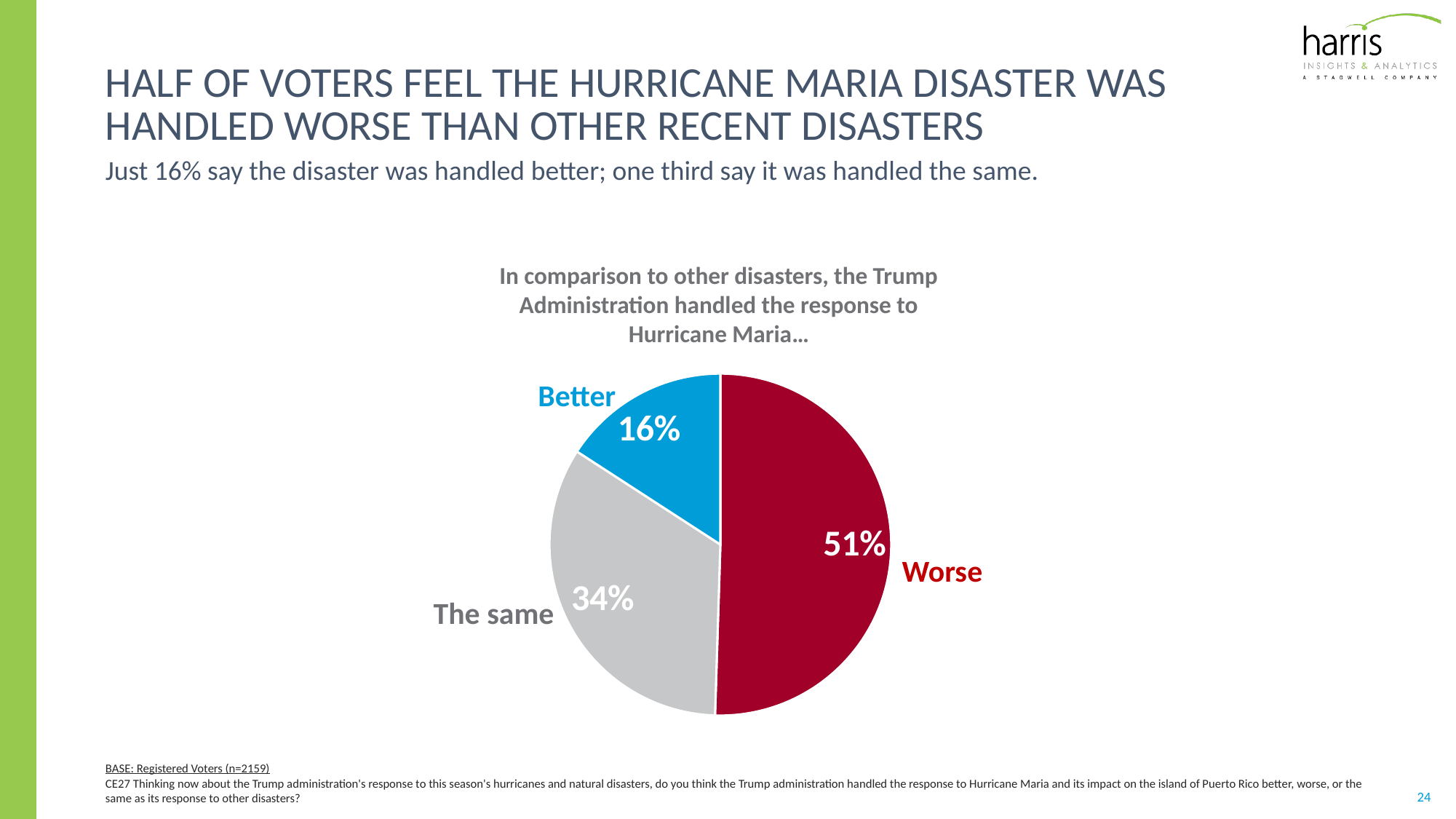
What is the difference in percentage points between the 'The same' and 'Better' slices? 18 How many slices does the pie chart have? 3 What percentage of voters say the response to Hurricane Maria was handled the same as other disasters? 34% Which slice is larger, 'The same' or 'Better'? The same What colour is the 'Better' slice of the pie chart? Blue What colour is the 'Worse' slice of the pie chart? Red What is the difference in percentage points between the 'Worse' and 'Better' slices? 35 What type of chart is shown on the slide? Pie chart Which response has the largest share of the pie? Worse What percentage of voters say the Trump Administration handled the response to Hurricane Maria worse than other disasters? 51% Which response has the smallest share of the pie? Better What percentage of voters say the response to Hurricane Maria was handled better than other disasters? 16%